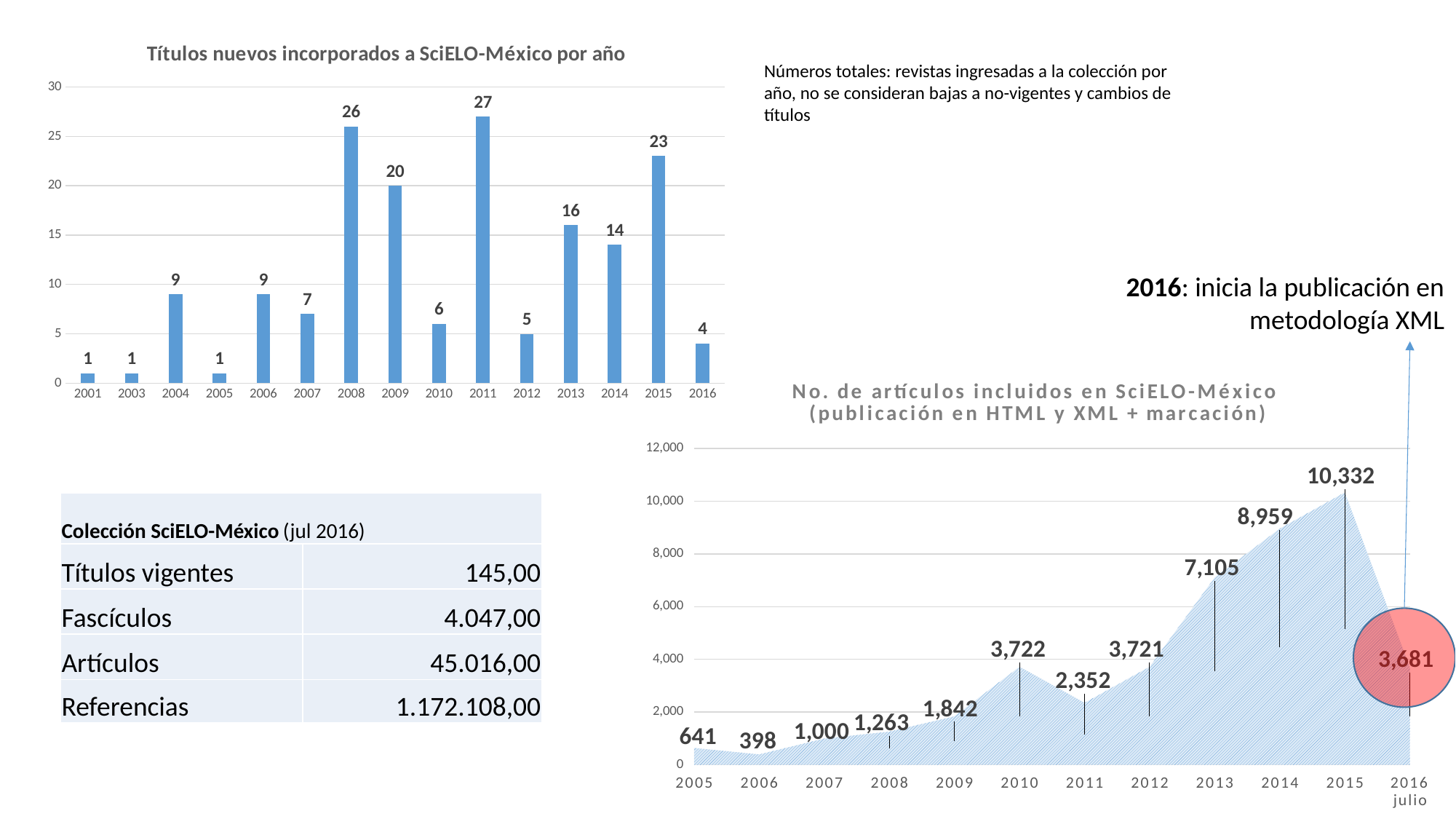
In the chart 'Títulos nuevos incorporados a SciELO-México por año', which year has the highest value? 2011 How many years are shown on the x axis of the chart 'Títulos nuevos incorporados a SciELO-México por año'? 15 What kind of chart is 'Títulos nuevos incorporados a SciELO-México por año'? bar chart In the chart 'No. de artículos incluidos en SciELO-México', what is the value for 2013? 7,105 In the chart 'No. de artículos incluidos en SciELO-México', which year has the lowest value? 2006 In the chart 'Títulos nuevos incorporados a SciELO-México por año', how many new titles were added in 2008? 26 In the chart 'No. de artículos incluidos en SciELO-México', do the values rise or fall from 2012 to 2015? rise How many data points are plotted in the chart 'No. de artículos incluidos en SciELO-México'? 12 In the chart 'No. de artículos incluidos en SciELO-México', which is larger, the value for 2010 or the value for 2011? 2010 In the chart 'No. de artículos incluidos en SciELO-México', what is the difference between the values for 2015 and 2014? 1,373 In the chart 'Títulos nuevos incorporados a SciELO-México por año', which is larger, the value for 2013 or the value for 2014? 2013 In the chart 'Títulos nuevos incorporados a SciELO-México por año', what is the difference between the values for 2015 and 2016? 19